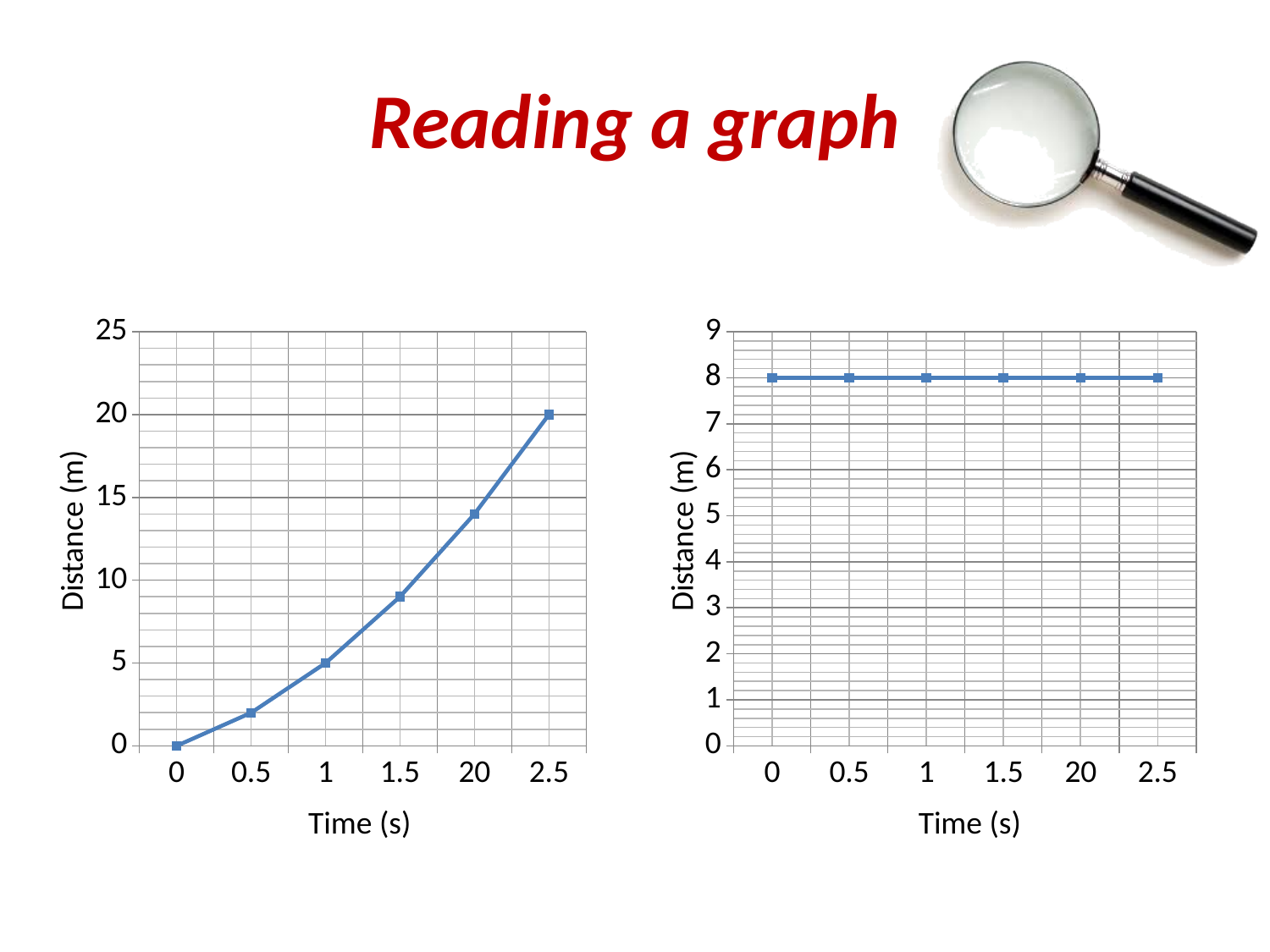
On the left chart, at which time is the distance highest? 2.5 On the left chart, is the distance at time 1.5 greater or less than 10? less On the left chart, what is the distance at time 0? 0 What kind of chart is the left chart? line chart How many data points are plotted on the left chart? 6 On the left chart, what is the distance at time 1? 5 What is the y-axis label on the right chart? Distance (m) On the right chart, what is the distance at time 1? 8 On the left chart, what is the distance at time 2.5? 20 On the left chart, what is the difference between the distance at time 2.5 and the distance at time 1? 15 On the right chart, do the values rise, fall or stay constant as time increases? stay constant On the left chart, do the values rise or fall as time increases? rise